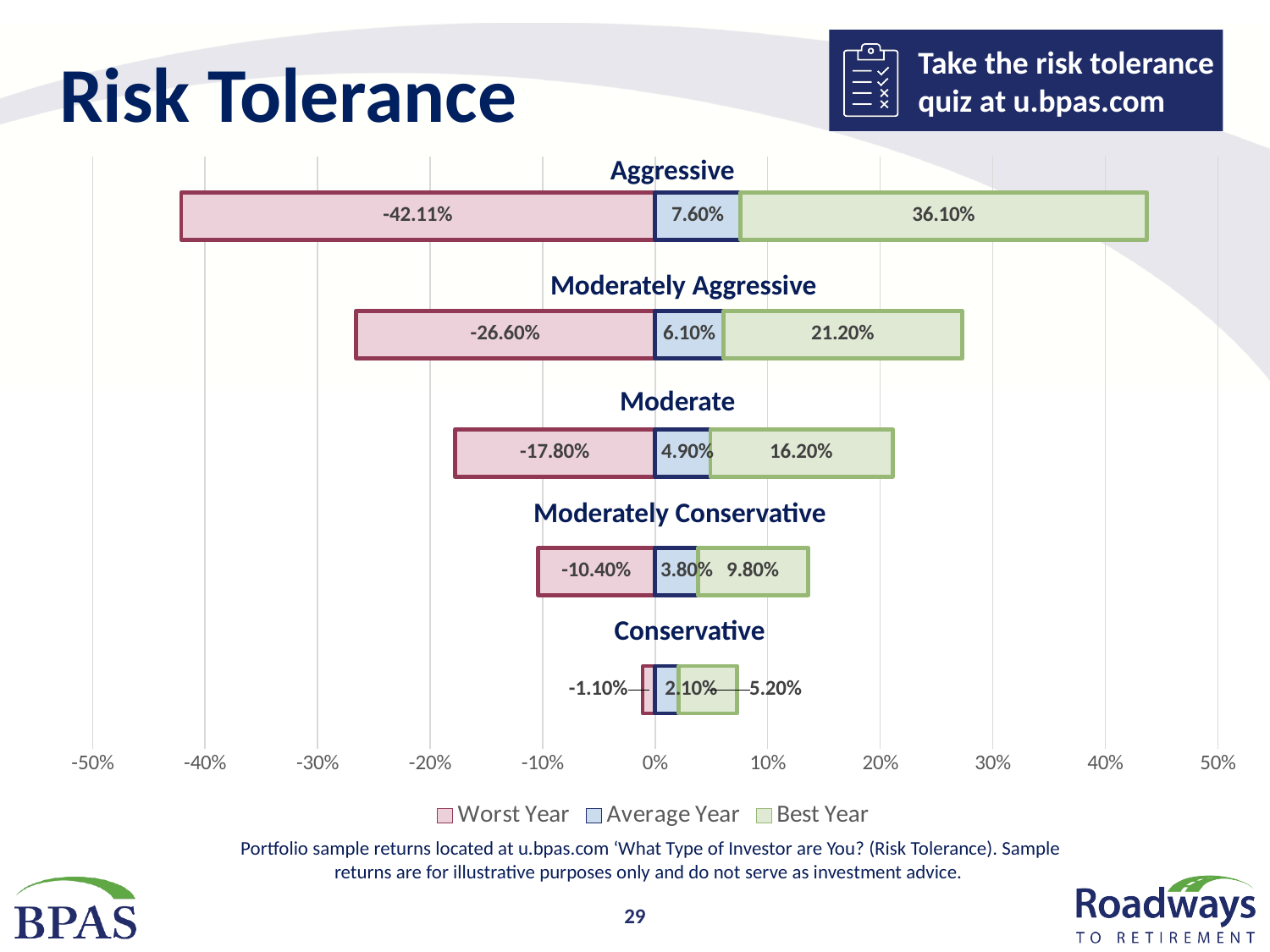
How many series does the legend list? 3 Which portfolio has the lowest Average Year value? Conservative How many portfolio categories are shown in the chart? 5 What is the Average Year value for the Moderate portfolio? 4.90% Which is larger: the Average Year value for Moderately Aggressive or for Moderately Conservative? Moderately Aggressive What is the Worst Year value for the Aggressive portfolio? -42.11% What is the difference between the Best Year values of the Aggressive and Moderate portfolios? 19.90% What is the Best Year value for the Moderately Aggressive portfolio? 21.20% What type of chart is shown on the slide? Bar chart Which legend entry is shown in green? Best Year Which portfolio has the highest Best Year value? Aggressive What is the Best Year value for the Conservative portfolio? 5.20%